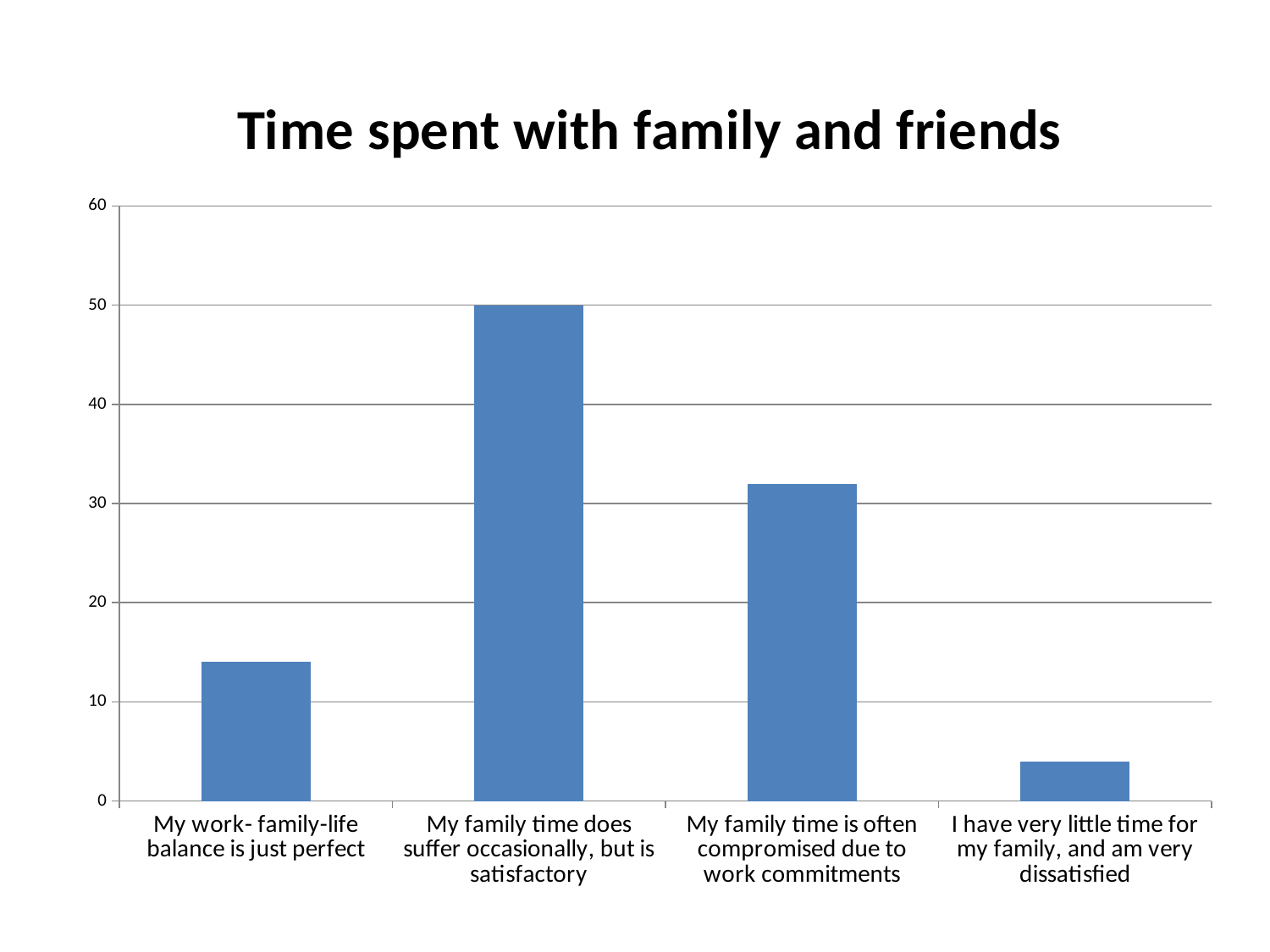
Is the value for "My work- family-life balance is just perfect" greater or less than 20? less What is the title of the chart? Time spent with family and friends How many categories are shown on the x axis of the chart? 4 What kind of chart is shown on the slide? bar chart Is the value for "I have very little time for my family, and am very dissatisfied" greater or less than 10? less Which category has the lowest value? I have very little time for my family, and am very dissatisfied What is the highest value shown on the vertical axis? 60 What is the value for "My family time does suffer occasionally, but is satisfactory"? 50 Is the value for "My work- family-life balance is just perfect" greater or less than 10? greater Which is larger: the value for "My family time is often compromised due to work commitments" or the value for "My work- family-life balance is just perfect"? My family time is often compromised due to work commitments Which category has the highest value? My family time does suffer occasionally, but is satisfactory